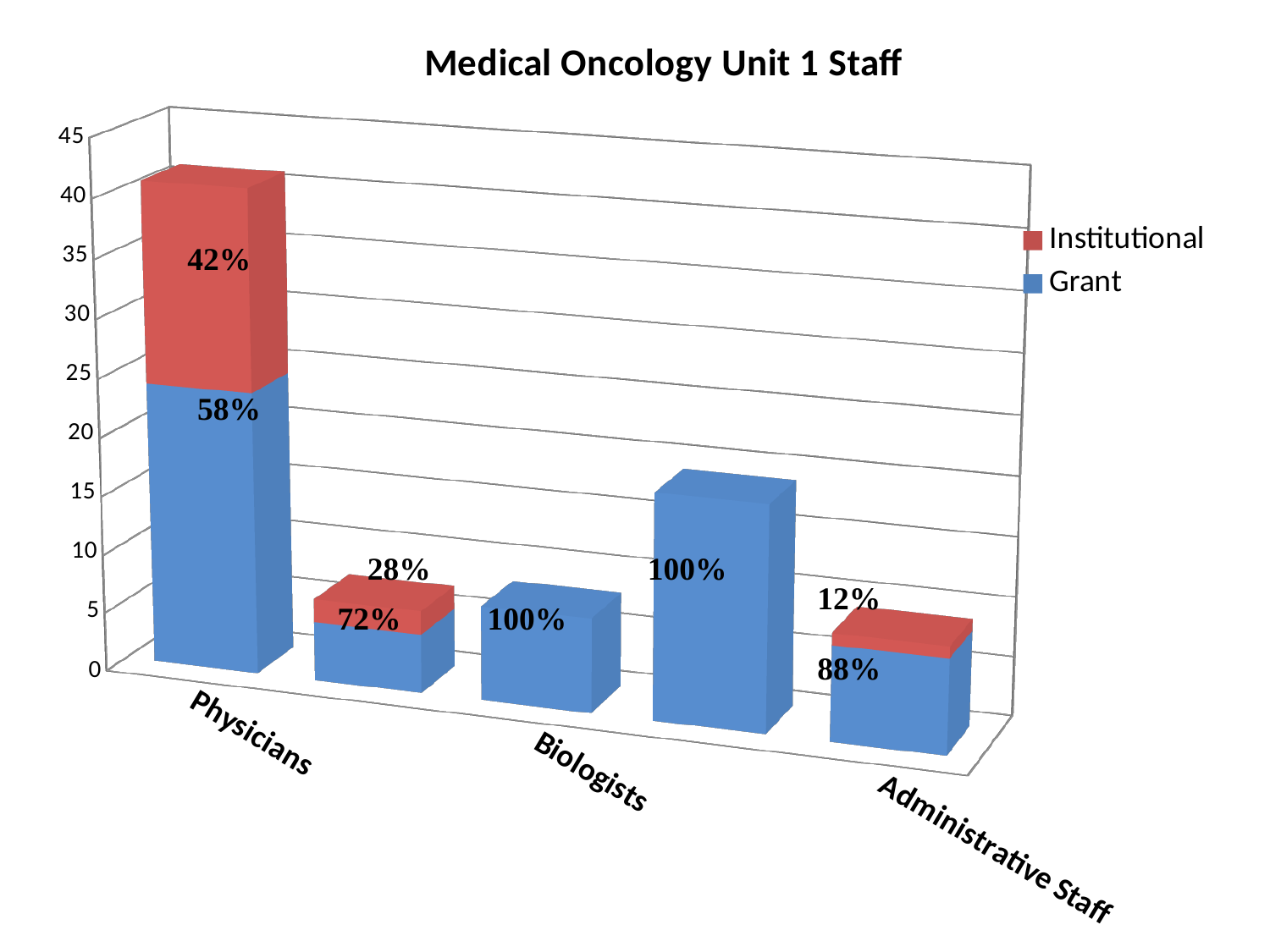
Is the total bar height for Physicians greater or less than 30? greater Which series is shown in red in the legend? Institutional How many series does the legend list? 2 What percentage of Biologists is labelled as Grant? 100% What percentage of Physicians is labelled as Grant? 58% What kind of chart is shown on the slide? Stacked bar chart How many bars are plotted in the chart? 5 What percentage of Administrative Staff is labelled as Grant? 88% What percentage of Administrative Staff is labelled as Institutional? 12% What is the title of the chart? Medical Oncology Unit 1 Staff Which category has the tallest bar? Physicians What percentage of Physicians is labelled as Institutional? 42%